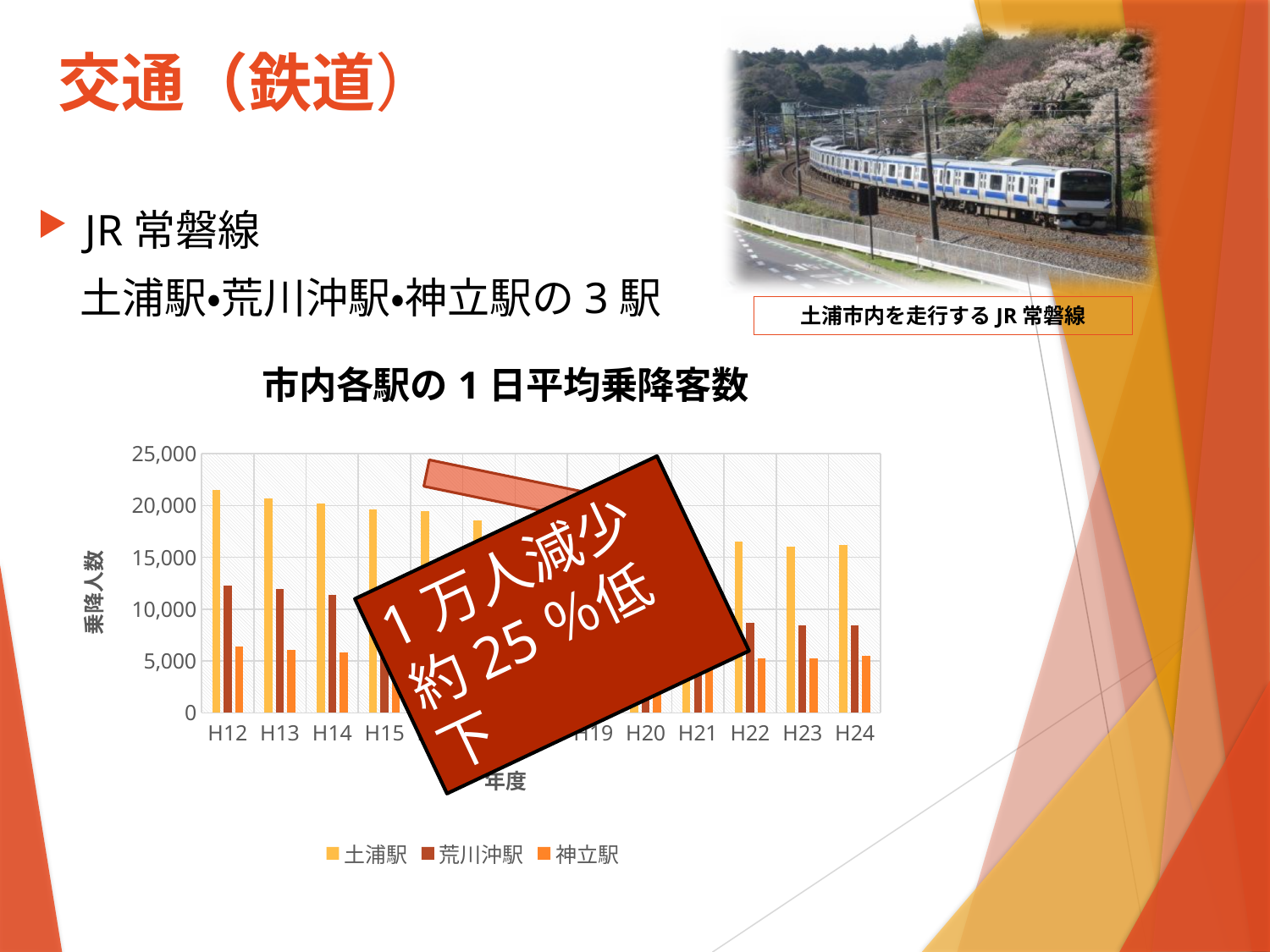
Is the value for 土浦駅 in H12 greater or less than 20,000? greater Is the value for 荒川沖駅 in H12 greater or less than 10,000? greater Do the values for 土浦駅 rise or fall from H12 to H24? fall Which station has the highest value in H12? 土浦駅 How many series does the chart legend list? 3 Is the value for 荒川沖駅 in H24 greater or less than 10,000? less Which stations are listed in the chart legend? 土浦駅, 荒川沖駅, 神立駅 What kind of chart is shown on the slide? bar chart What is the title of the chart? 市内各駅の1日平均乗降客数 Which station has the lowest value in H12? 神立駅